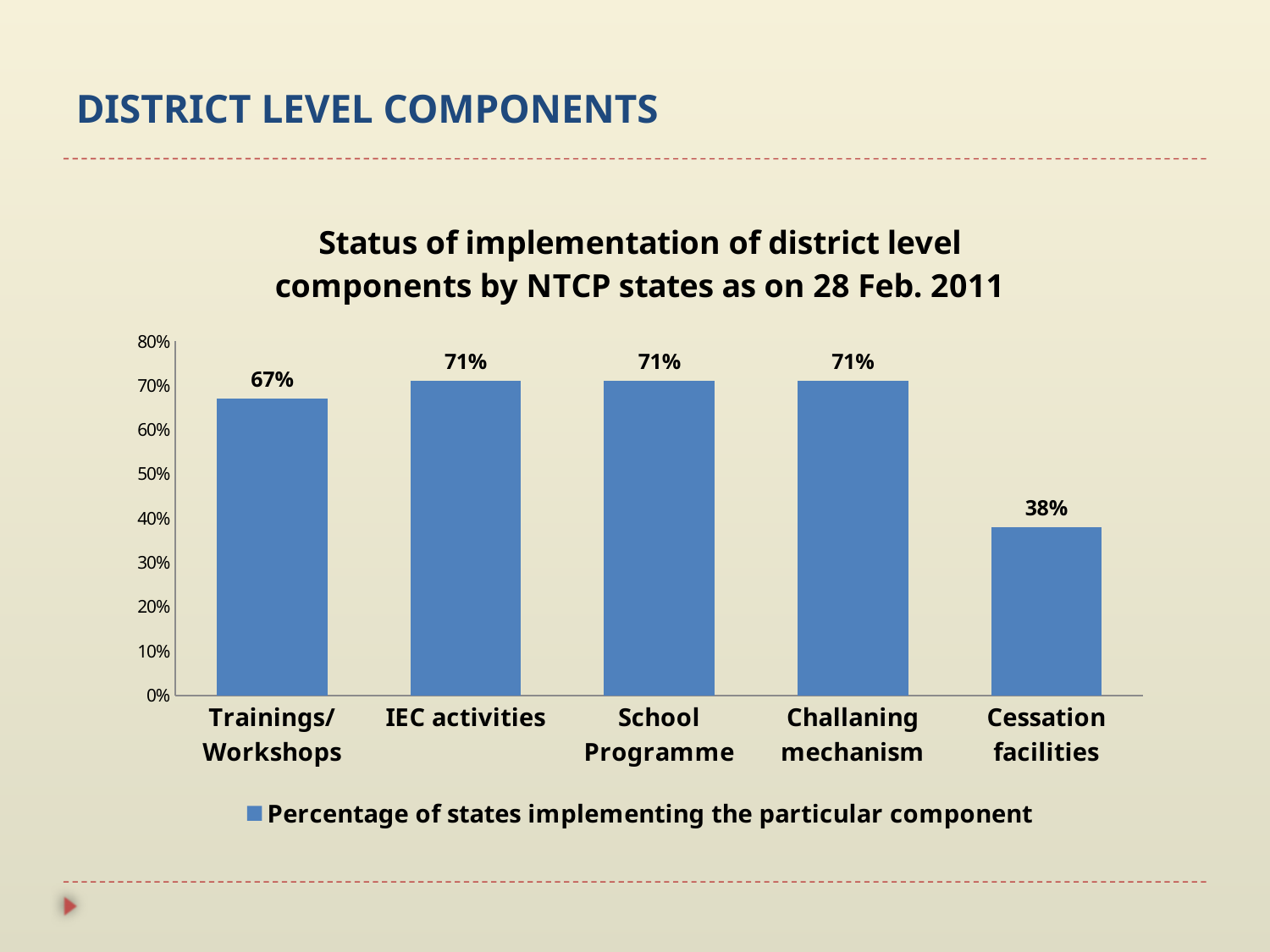
What is the value shown for Cessation facilities? 38% Which is larger, the value for Trainings/Workshops or the value for Cessation facilities? Trainings/Workshops Which component has the lowest percentage of states implementing it? Cessation facilities How many components are shown on the x axis? 5 What percentage of states are implementing Trainings/Workshops? 67% What is the title of the chart? Status of implementation of district level components by NTCP states as on 28 Feb. 2011 What kind of chart is shown on the slide? bar chart What percentage of states are implementing the Challaning mechanism? 71% What is the difference between the values for School Programme and Trainings/Workshops? 4% How many series does the legend list? 1 Is the value for Cessation facilities greater or less than 40%? less What is the difference between the values for IEC activities and Cessation facilities? 33%